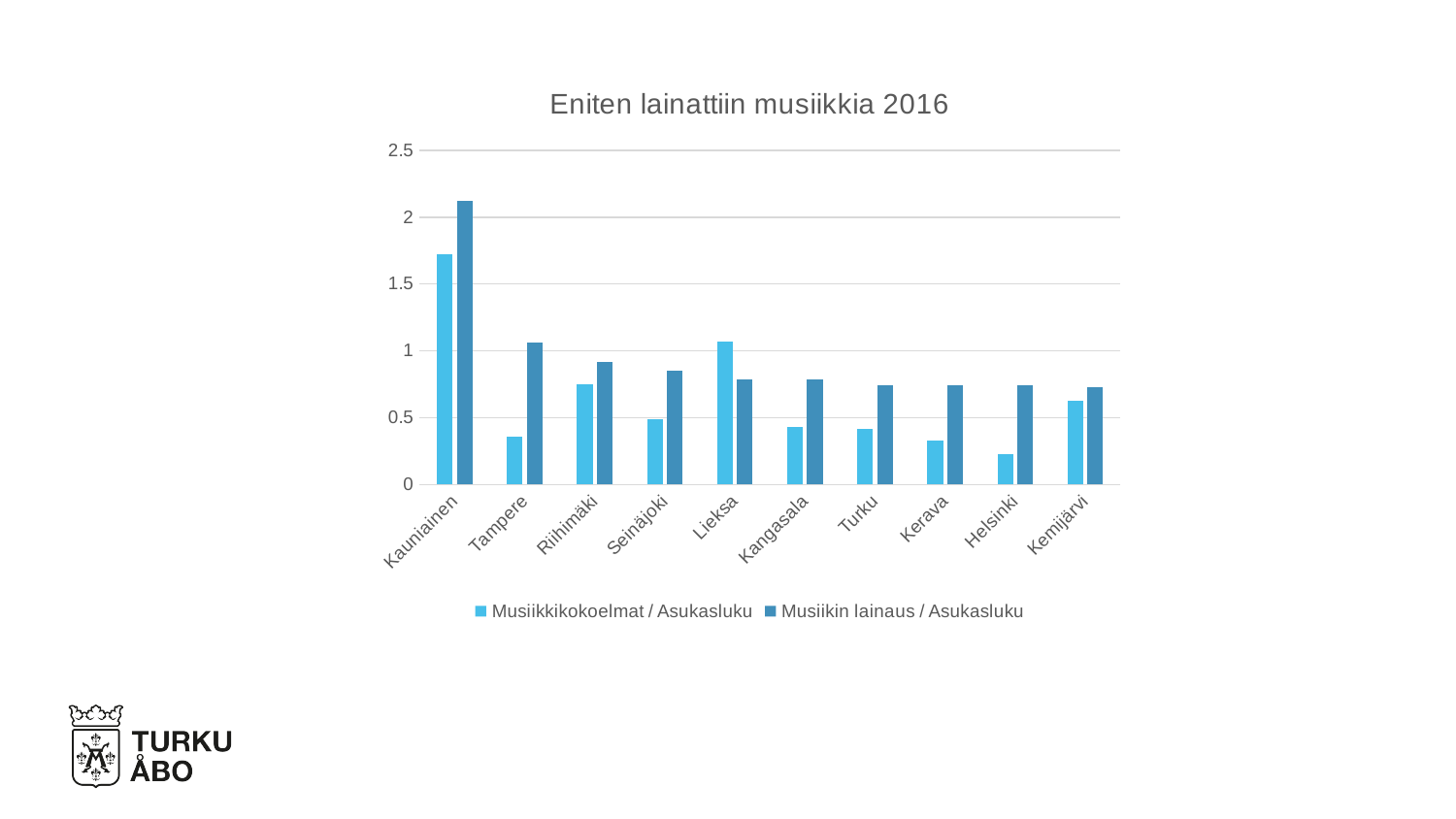
Which has the larger Musiikin lainaus / Asukasluku value, Tampere or Turku? Tampere Is the Musiikkikokoelmat / Asukasluku value for Helsinki greater or less than 0.5? less Is the Musiikin lainaus / Asukasluku value for Tampere greater or less than 1? greater What is the title of the chart? Eniten lainattiin musiikkia 2016 For Lieksa, which series has the larger value: Musiikkikokoelmat / Asukasluku or Musiikin lainaus / Asukasluku? Musiikkikokoelmat / Asukasluku Which municipality has the highest value for Musiikin lainaus / Asukasluku? Kauniainen What kind of chart is shown on the slide? Bar chart How many series does the legend list? 2 Is the Musiikkikokoelmat / Asukasluku value for Lieksa greater or less than 1? greater Which municipality has the lowest value for Musiikkikokoelmat / Asukasluku? Helsinki How many municipalities are shown on the x axis? 10